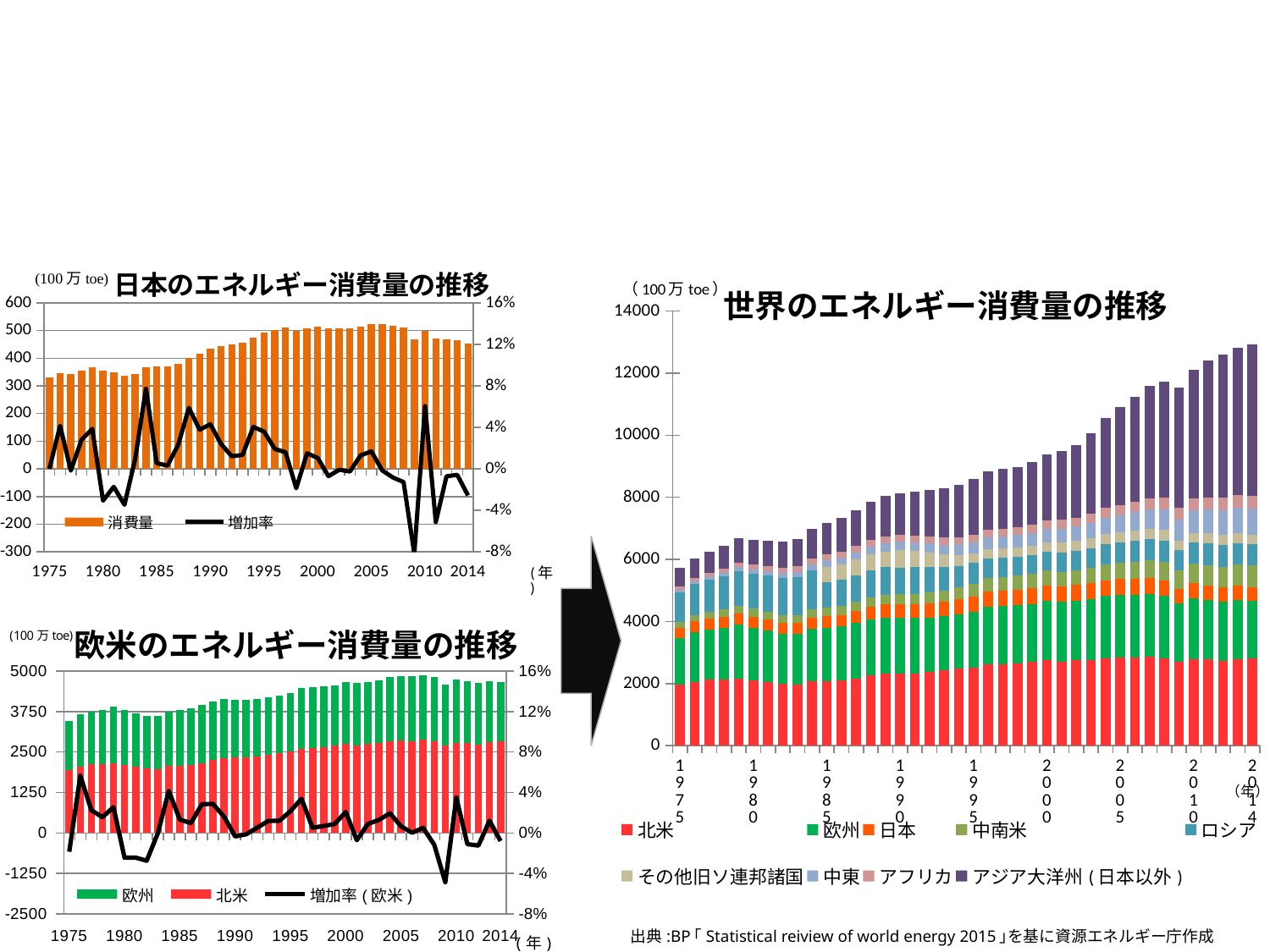
In the chart titled 日本のエネルギー消費量の推移, how many series does the legend list? 2 In the chart titled 世界のエネルギー消費量の推移, how many series does the legend list? 9 What kind of chart is the chart titled 世界のエネルギー消費量の推移? stacked bar chart In the chart titled 欧米のエネルギー消費量の推移, is the total stacked bar for 2014 greater or less than 3750? greater In the chart titled 欧米のエネルギー消費量の推移, how many series does the legend list? 3 In the chart titled 日本のエネルギー消費量の推移, is the 消費量 value for 2005 greater or less than 400? greater In the chart titled 世界のエネルギー消費量の推移, do the total values generally rise or fall from 1975 to 2014? rise In the chart titled 世界のエネルギー消費量の推移, is the total stacked bar for 1975 greater or less than 6000? less In the chart titled 欧米のエネルギー消費量の推移, which series is drawn as a black line? 増加率(欧米)